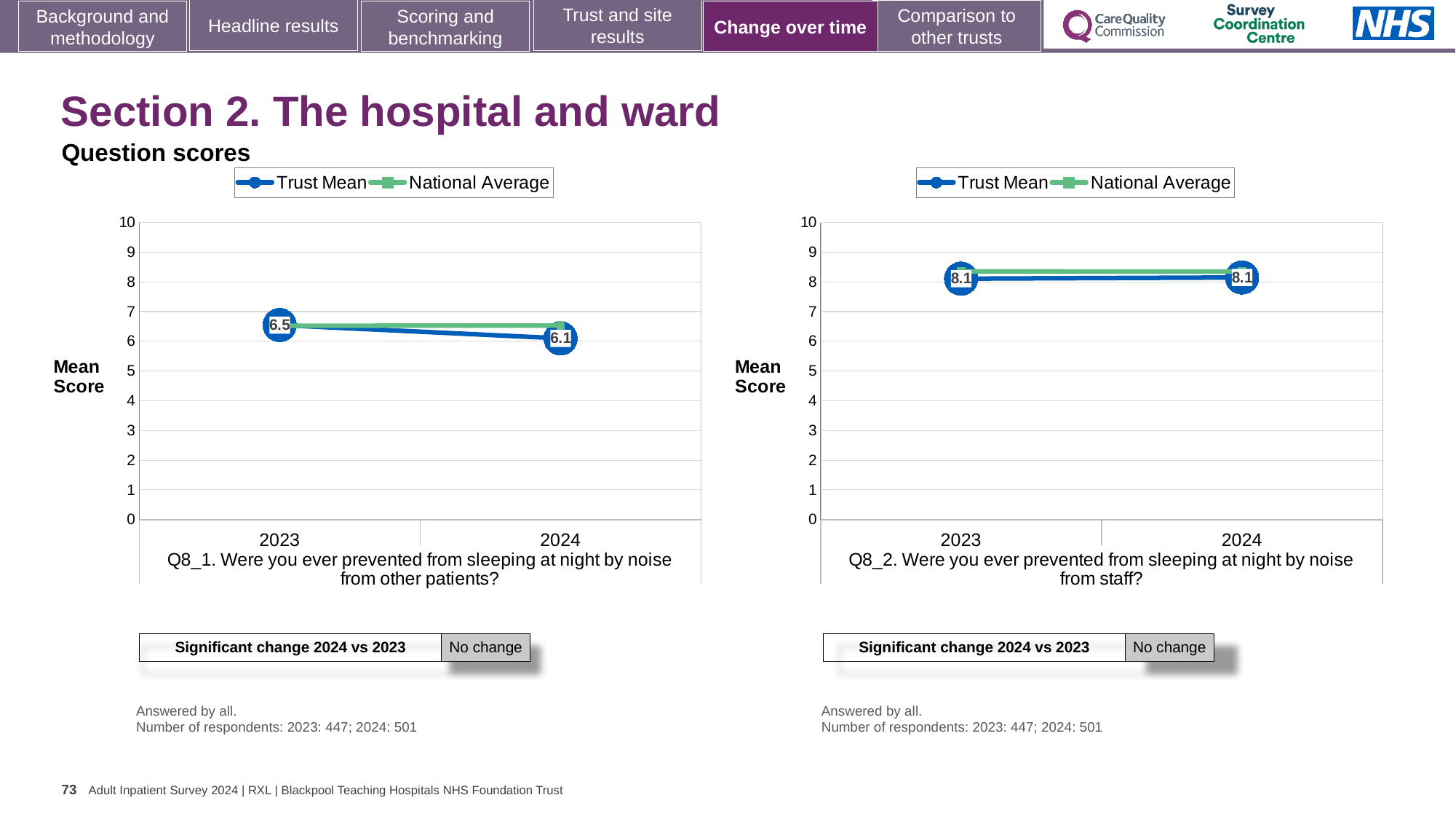
In the Q8_2 chart (right), does the Trust Mean rise, fall or stay the same from 2023 to 2024? stay the same In the Q8_1 chart (left), is the National Average for 2024 greater or less than 5? greater In the Q8_1 chart (left), does the Trust Mean rise or fall from 2023 to 2024? fall In the Q8_1 chart (left), which year has the higher Trust Mean, 2023 or 2024? 2023 How many series does the legend of the Q8_2 chart (right) list? 2 In the Q8_1 chart (left), what is the Trust Mean for 2023? 6.5 How many years are shown on the x axis of the Q8_1 chart (left)? 2 In the Q8_2 chart (right), is the National Average for 2024 greater or less than 7? greater What kind of chart is the Q8_1 chart (left)? line chart In the Q8_2 chart (right), what is the Trust Mean for 2024? 8.1 In the Q8_1 chart (left), what is the Trust Mean for 2024? 6.1 In the Q8_1 chart (left), what is the difference between the Trust Mean for 2023 and 2024? 0.4